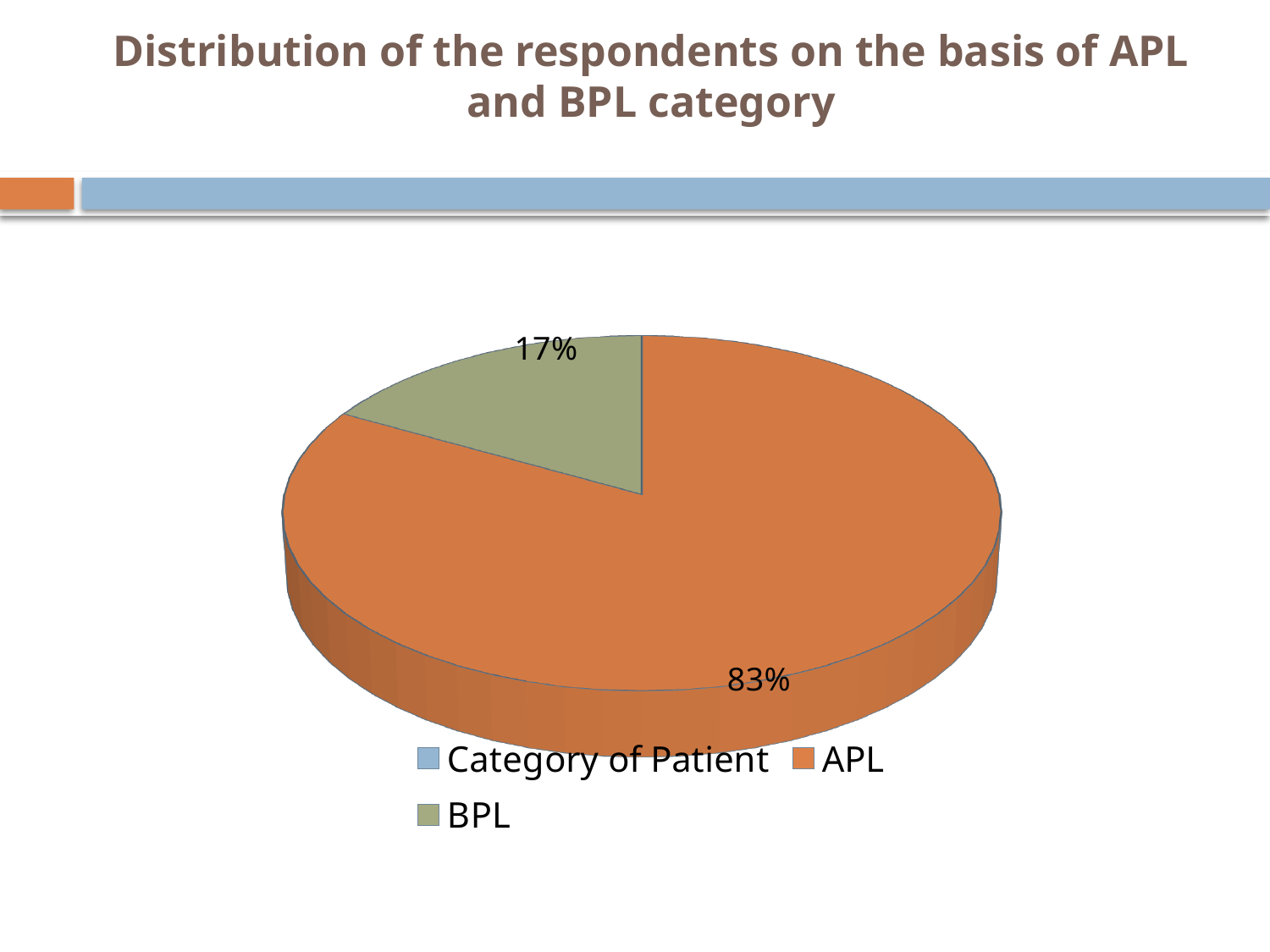
What share of the pie does BPL account for? 17% What kind of chart is shown on the slide? Pie chart What share of the pie does APL account for? 83% How many entries does the legend list? 3 What is the title of the slide? Distribution of the respondents on the basis of APL and BPL category What colour is the APL slice of the pie? Orange Which is larger, the APL slice or the BPL slice? APL What is the difference in percentage points between the APL and BPL slices? 66 Which category has the smallest visible slice of the pie? BPL Is the share for BPL greater or less than 50%? less Which category has the largest slice of the pie? APL How many slices are visible in the pie chart? 2